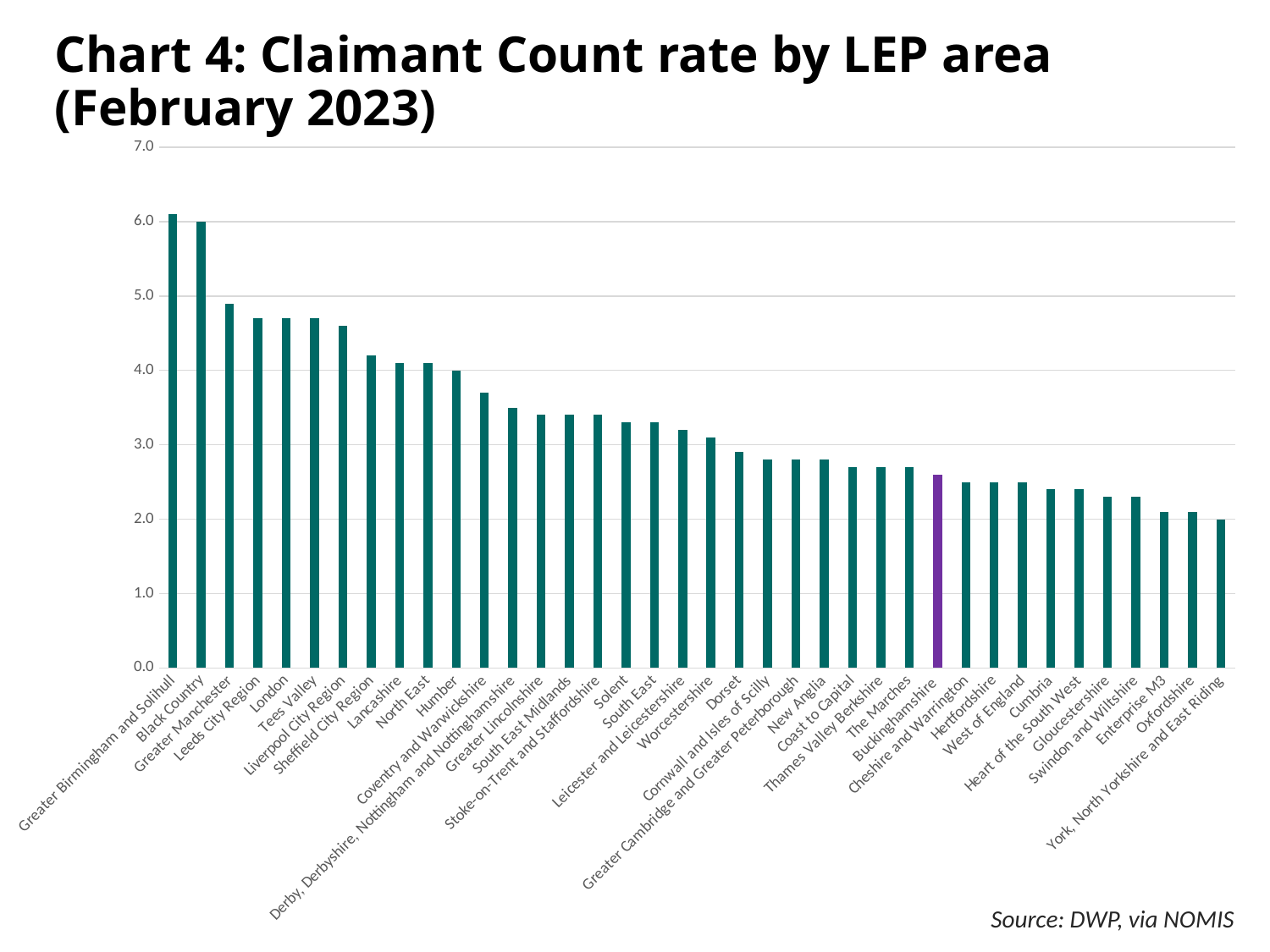
Which LEP area has the highest Claimant Count rate? Greater Birmingham and Solihull Is the value for London greater or less than 5.0? less Is the value for York, North Yorkshire and East Riding greater or less than 3.0? less Which LEP area's bar is highlighted in purple? Buckinghamshire What kind of chart is shown on the slide? Bar chart Which has a higher Claimant Count rate, London or Buckinghamshire? London Which has a higher Claimant Count rate, Greater Manchester or Cumbria? Greater Manchester Which LEP area has the lowest Claimant Count rate? York, North Yorkshire and East Riding Is the value for Black Country greater or less than 5.0? greater Do the values rise or fall moving from left to right along the x axis? Fall